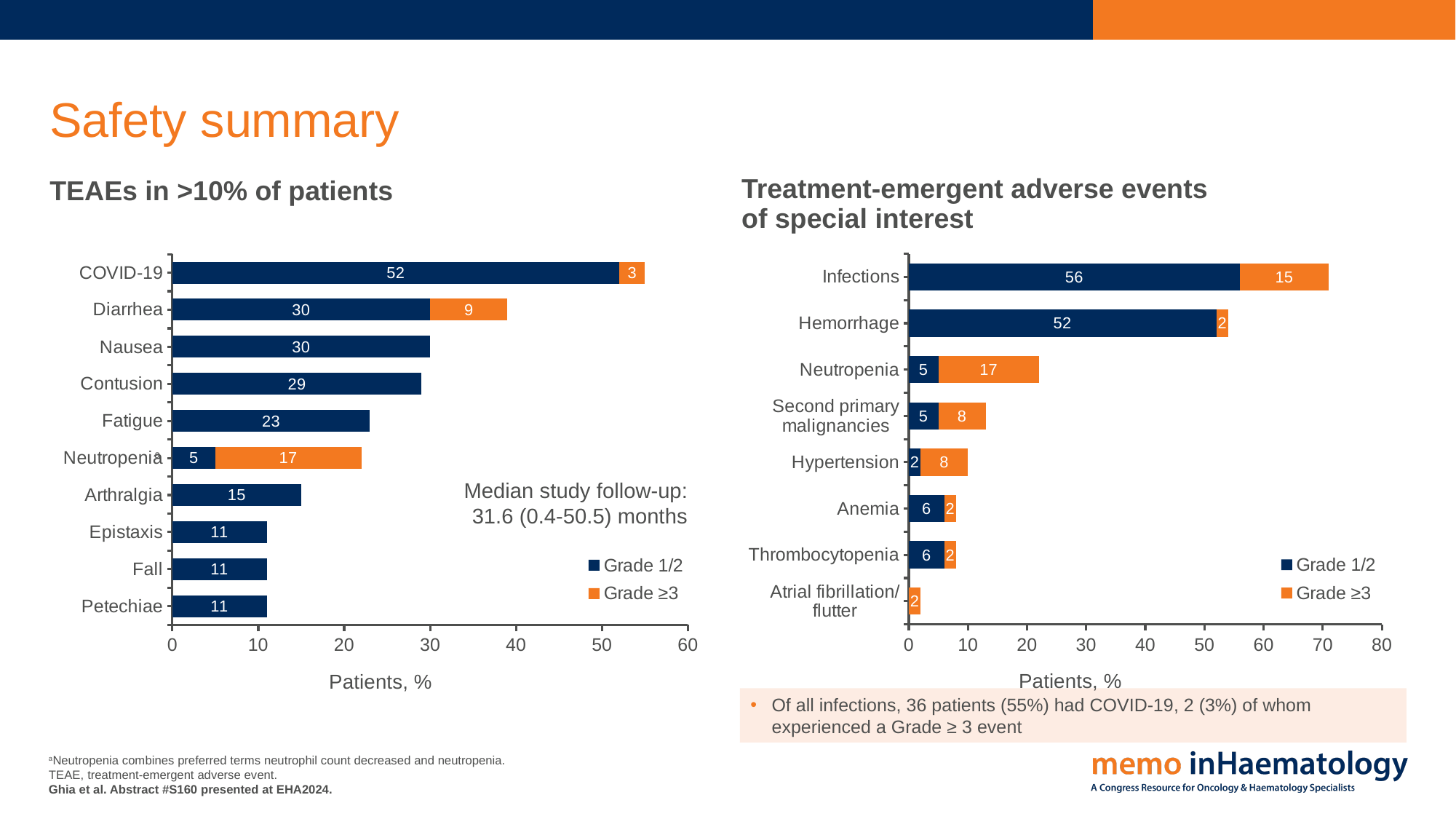
In the 'Treatment-emergent adverse events of special interest' chart, which is larger: the Grade 1/2 value for Hemorrhage or the Grade 1/2 value for Neutropenia? Hemorrhage In the 'TEAEs in >10% of patients' chart, what is the Grade ≥3 value for Diarrhea? 9 In the 'TEAEs in >10% of patients' chart, what is the Grade 1/2 value for COVID-19? 52 What kind of chart is the 'Treatment-emergent adverse events of special interest' chart? Stacked bar chart In the 'TEAEs in >10% of patients' chart, how many adverse event categories are shown? 10 In the 'Treatment-emergent adverse events of special interest' chart, which category has the highest Grade ≥3 value? Neutropenia In the 'Treatment-emergent adverse events of special interest' chart, how many series does the legend list? 2 In the 'Treatment-emergent adverse events of special interest' chart, what is the Grade ≥3 value for Infections? 15 In the 'TEAEs in >10% of patients' chart, what is the difference between the Grade 1/2 values for Fatigue and Arthralgia? 8 In the 'TEAEs in >10% of patients' chart, which category has the highest Grade 1/2 value? COVID-19 In the 'Treatment-emergent adverse events of special interest' chart, what is the total of the stacked bar for Infections? 71 In the 'TEAEs in >10% of patients' chart, what is the total of the stacked bar for Neutropenia? 22